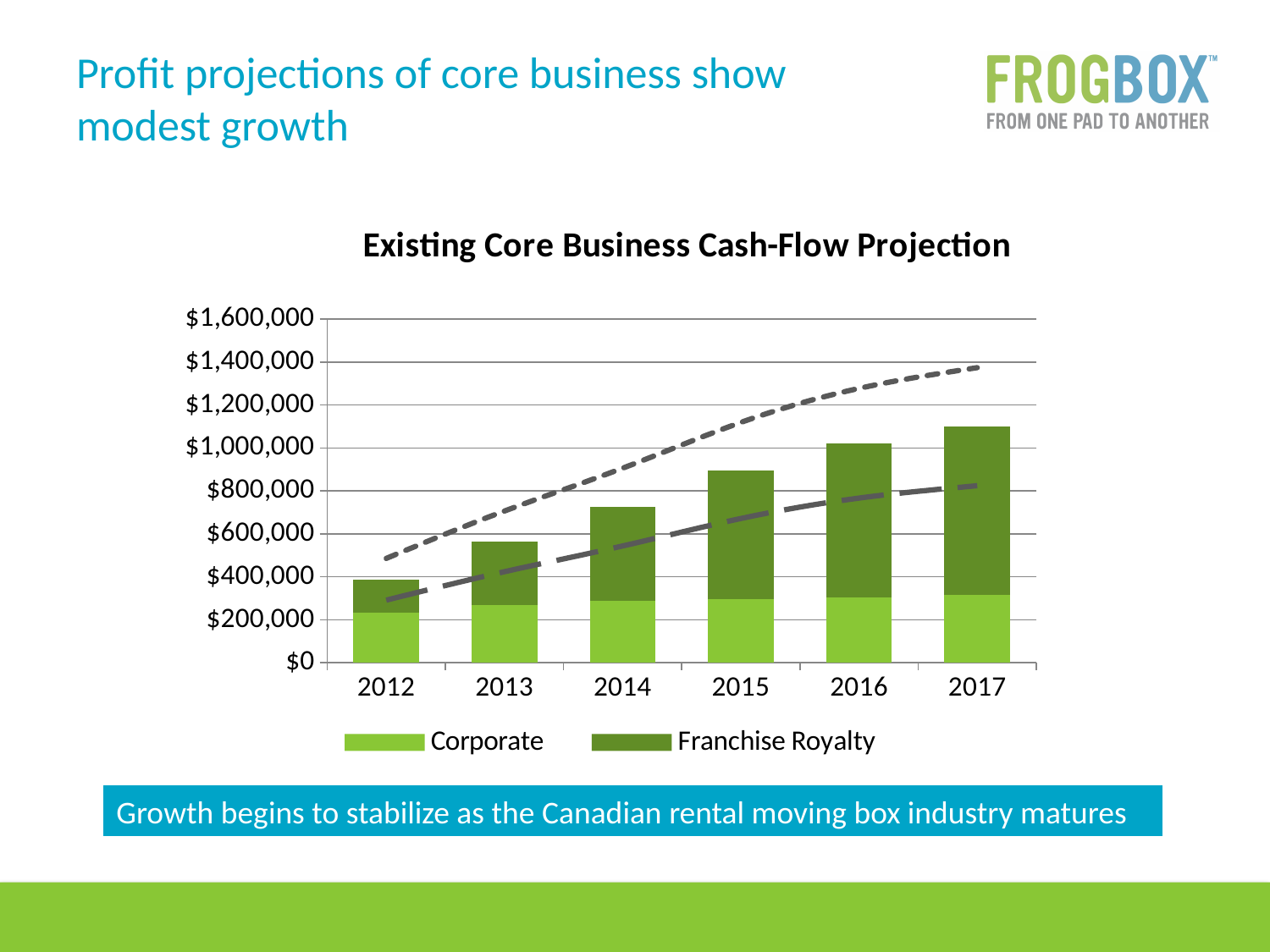
Is the total stacked bar for 2014 greater or less than $600,000? greater Is the total stacked bar for 2015 greater or less than $1,000,000? less Which series is shown in the darker green colour in the legend? Franchise Royalty What is the title of the chart? Existing Core Business Cash-Flow Projection How many series does the chart legend list? 2 Do the stacked bar totals rise or fall from 2012 to 2017? Rise Which year has the larger stacked bar total, 2013 or 2016? 2016 Is the total stacked bar for 2017 greater or less than $1,000,000? greater Which year has the shortest stacked bar? 2012 Which year has the tallest stacked bar? 2017 What kind of chart is shown on the slide? Combination stacked bar and line chart How many years are shown on the x axis of the chart? 6